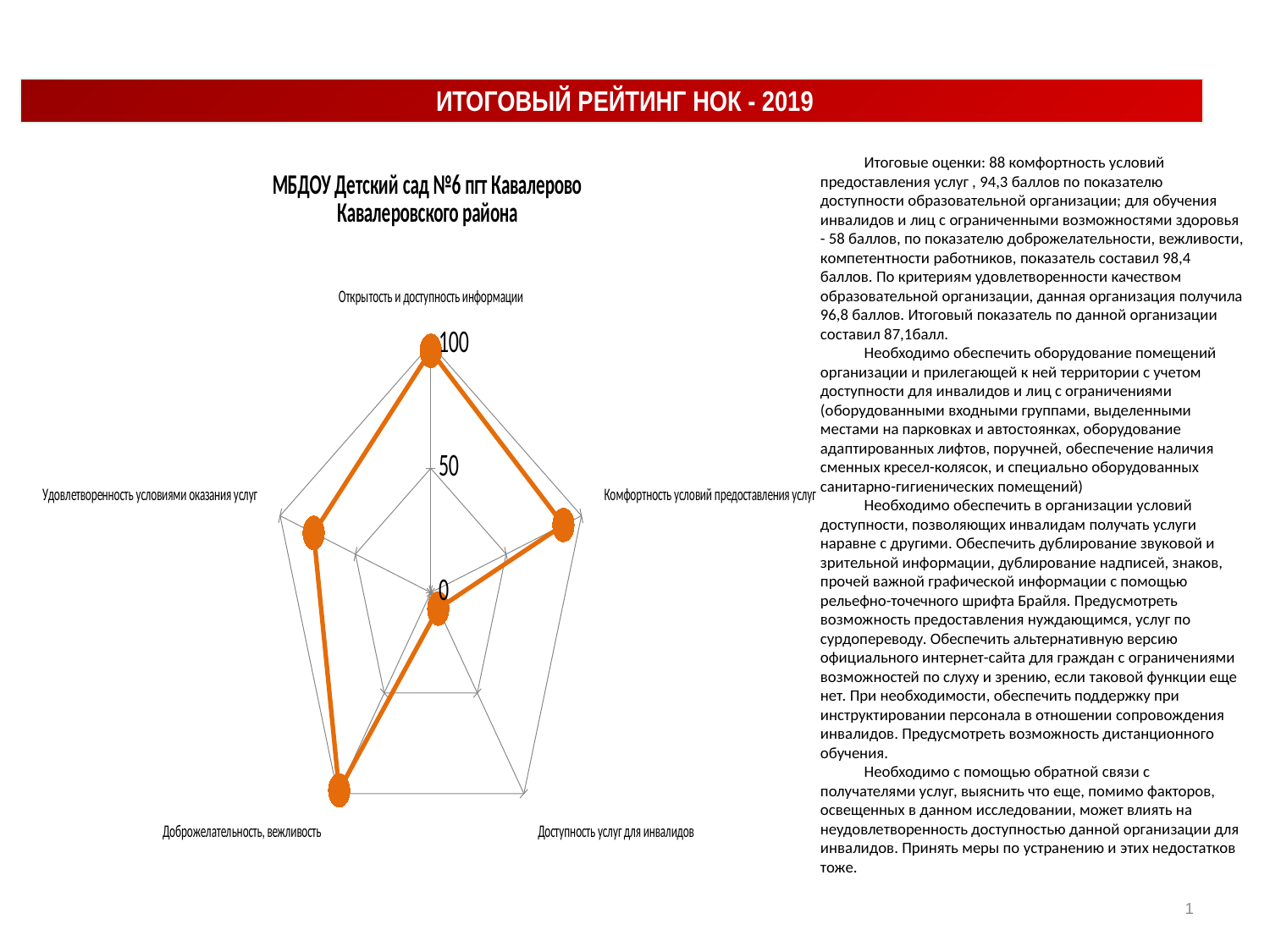
Is the value for Доброжелательность, вежливость greater or less than 50? greater What is the title of the chart? МБДОУ Детский сад №6 пгт Кавалерово Кавалеровского района Which is larger: the value for Доброжелательность, вежливость or the value for Доступность услуг для инвалидов? Доброжелательность, вежливость What kind of chart is shown on the slide? radar chart Is the value for Доступность услуг для инвалидов greater or less than 50? less Is the value for Комфортность условий предоставления услуг greater or less than 50? greater Which is larger: the value for Комфортность условий предоставления услуг or the value for Доступность услуг для инвалидов? Комфортность условий предоставления услуг How many categories (axes) does the radar chart have? 5 What is the highest tick value shown on the chart's axis? 100 Which category has the lowest value on the chart? Доступность услуг для инвалидов